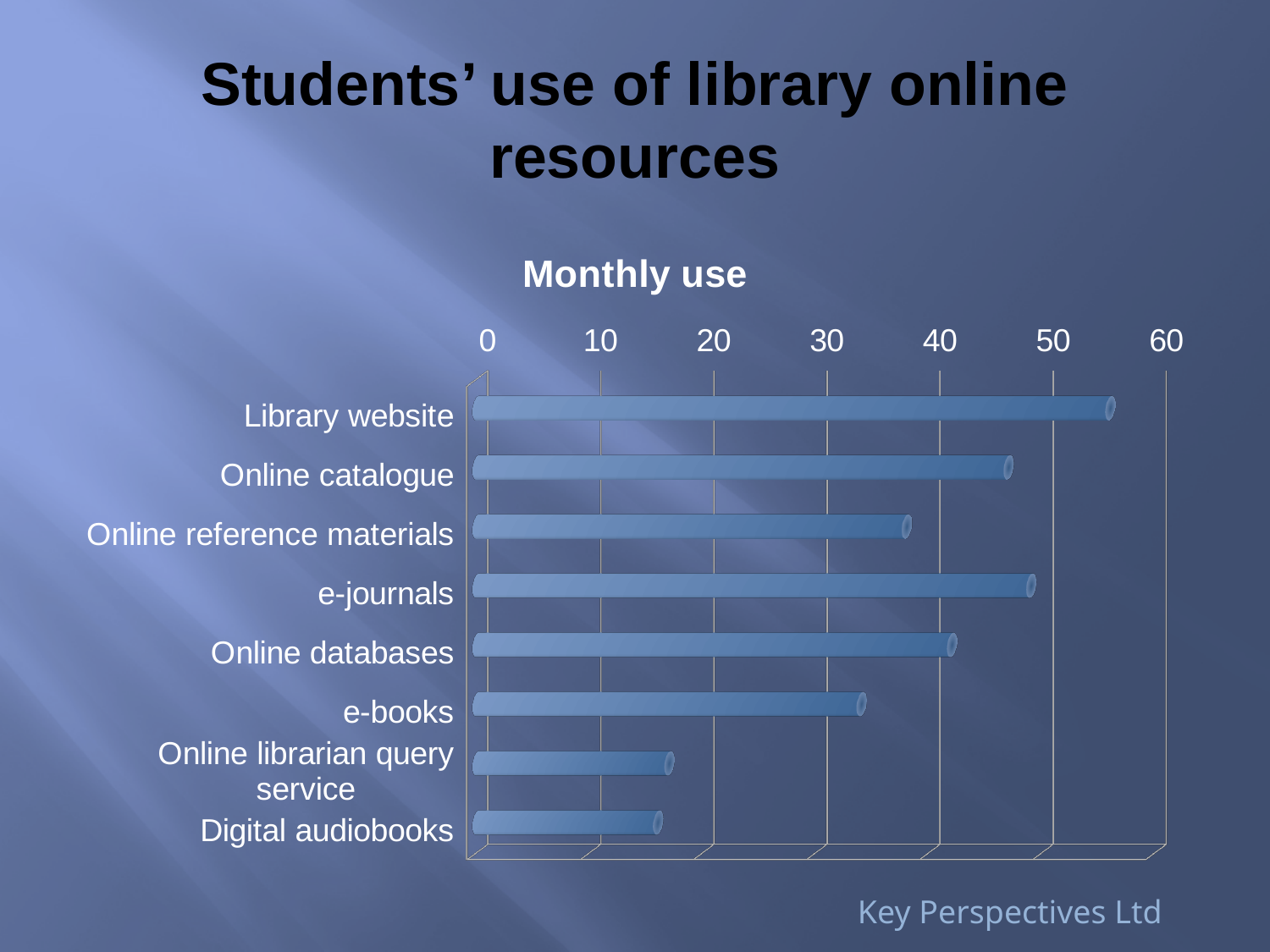
Is the value for e-books greater or less than 30? greater What kind of chart is shown on the slide? Bar chart Which has a higher monthly use, Online catalogue or Online reference materials? Online catalogue What is the title of the chart? Monthly use Is the value for e-journals greater or less than 40? greater Is the value for Library website greater or less than 50? greater How many categories are plotted in the chart? 8 Which has a higher monthly use, e-books or Online databases? Online databases Which has a higher monthly use, Library website or e-journals? Library website Which category has the highest monthly use? Library website